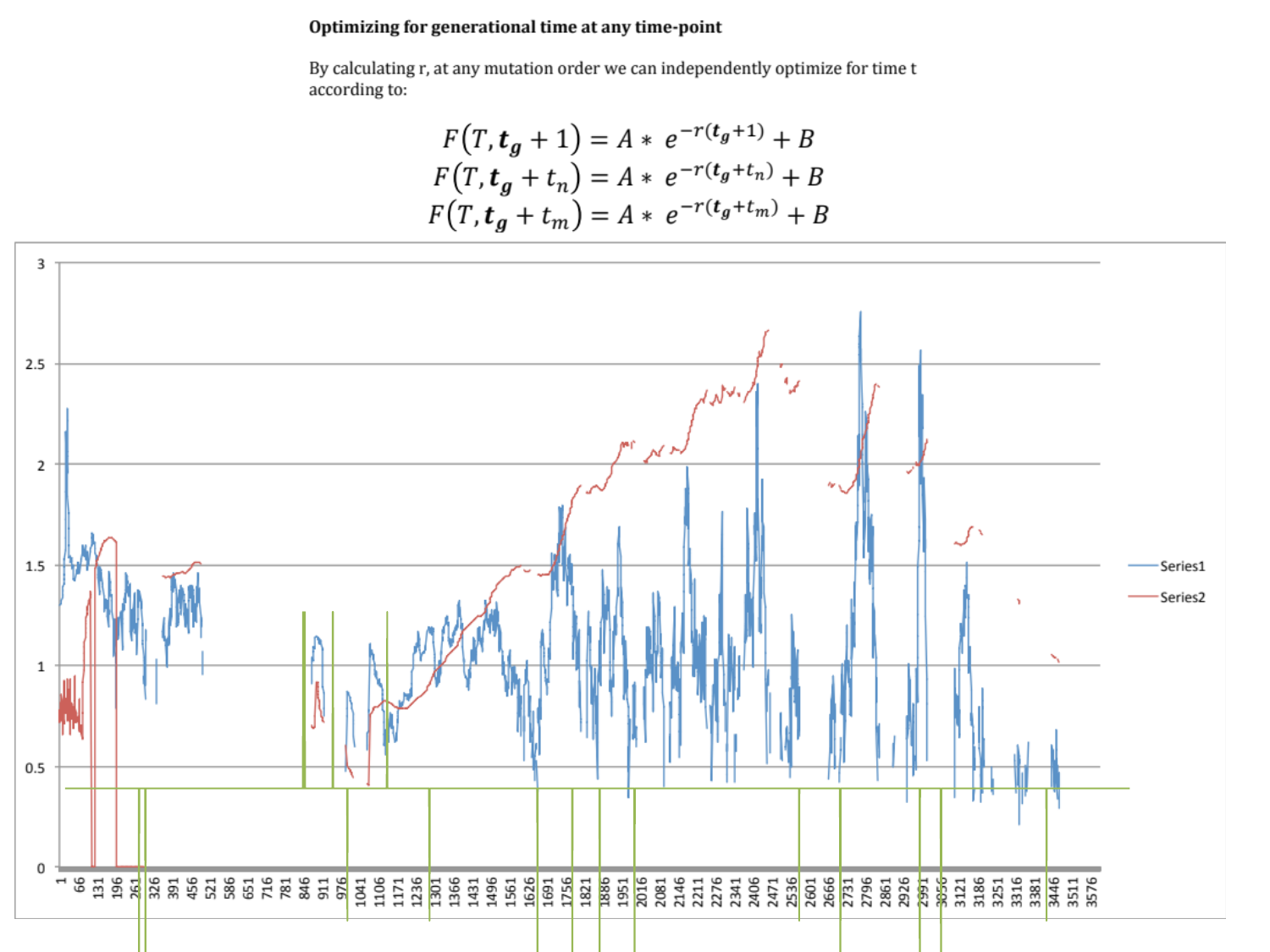
How many series does the legend list? 2 Is the peak value of Series2 (around x = 2406–2471) greater or less than 2.5? greater Is the value of Series1 at the start of the x axis (around x = 1) greater or less than 1? greater What kind of chart is shown on the slide? line chart Around x = 2796, which series reaches the higher value, Series1 or Series2? Series1 Is the value of Series2 around x = 2276 greater or less than 2? greater What colour is the line for Series2? red What are the names of the series in the legend? Series1 and Series2 What is the highest value shown on the vertical axis? 3 Does Series2 rise or fall between roughly x = 1171 and x = 2471? rise